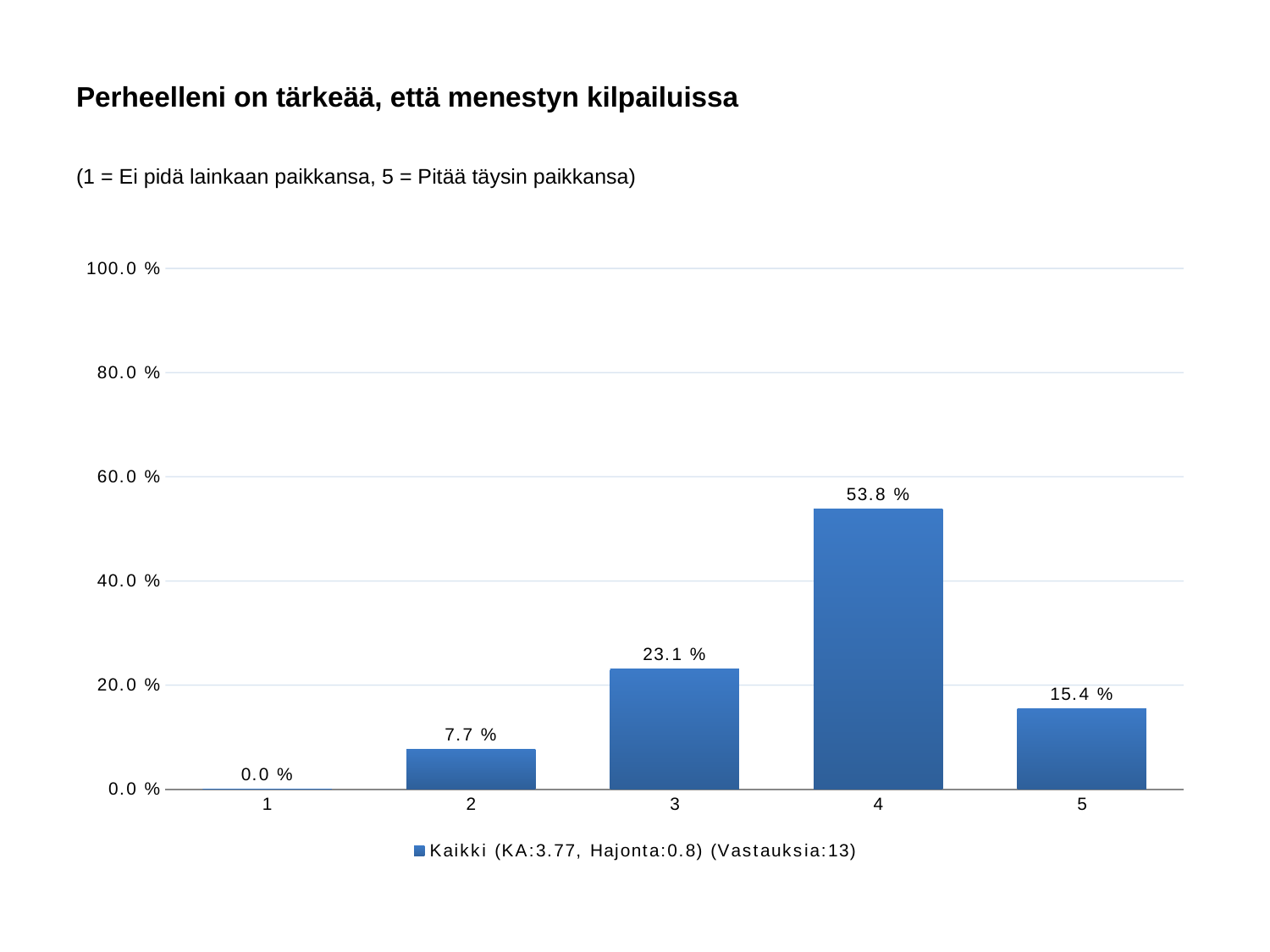
What is the value for category 2? 7.7 % How many series does the legend list? 1 Which category has the lowest value? 1 How many categories are shown on the x axis? 5 What is the difference between the values for category 4 and category 3? 30.7 % Which is larger, the value for category 3 or the value for category 5? 3 What kind of chart is shown? bar chart What is the value for category 4? 53.8 % Is the value for category 4 greater or less than 40.0 %? greater Which category has the highest value? 4 What is the value for category 5? 15.4 % What is the legend entry for the series? Kaikki (KA:3.77, Hajonta:0.8) (Vastauksia:13)